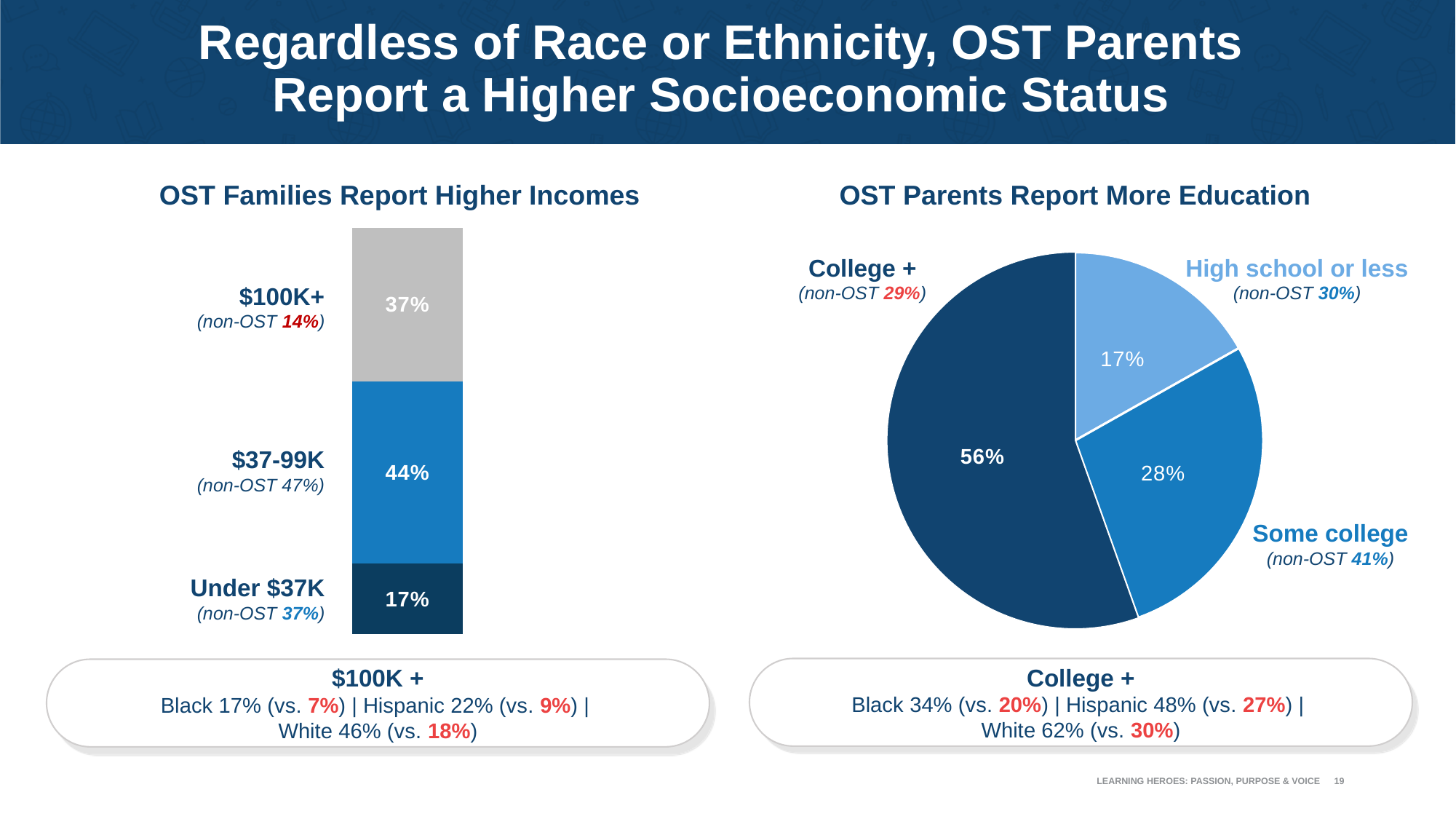
What type of chart is 'OST Parents Report More Education'? Pie chart In the 'OST Families Report Higher Incomes' chart, which income category has the smallest share of OST families? Under $37K In the 'OST Families Report Higher Incomes' chart, how many income categories are shown in the stacked bar? 3 In the 'OST Parents Report More Education' chart, what percentage of OST parents have College +? 56% What type of chart is 'OST Families Report Higher Incomes'? Stacked bar chart In the 'OST Families Report Higher Incomes' chart, what is the difference between the $37-99K share and the Under $37K share? 27% In the 'OST Parents Report More Education' chart, which education level has the largest slice? College + In the 'OST Parents Report More Education' chart, which is larger: Some college or High school or less? Some college In the 'OST Parents Report More Education' chart, what percentage of OST parents have High school or less? 17% In the 'OST Families Report Higher Incomes' chart, what percentage of OST families report an income of $100K+? 37% In the 'OST Families Report Higher Incomes' chart, which income category has the largest share of OST families? $37-99K In the 'OST Families Report Higher Incomes' chart, what percentage of OST families report an income of $37-99K? 44%